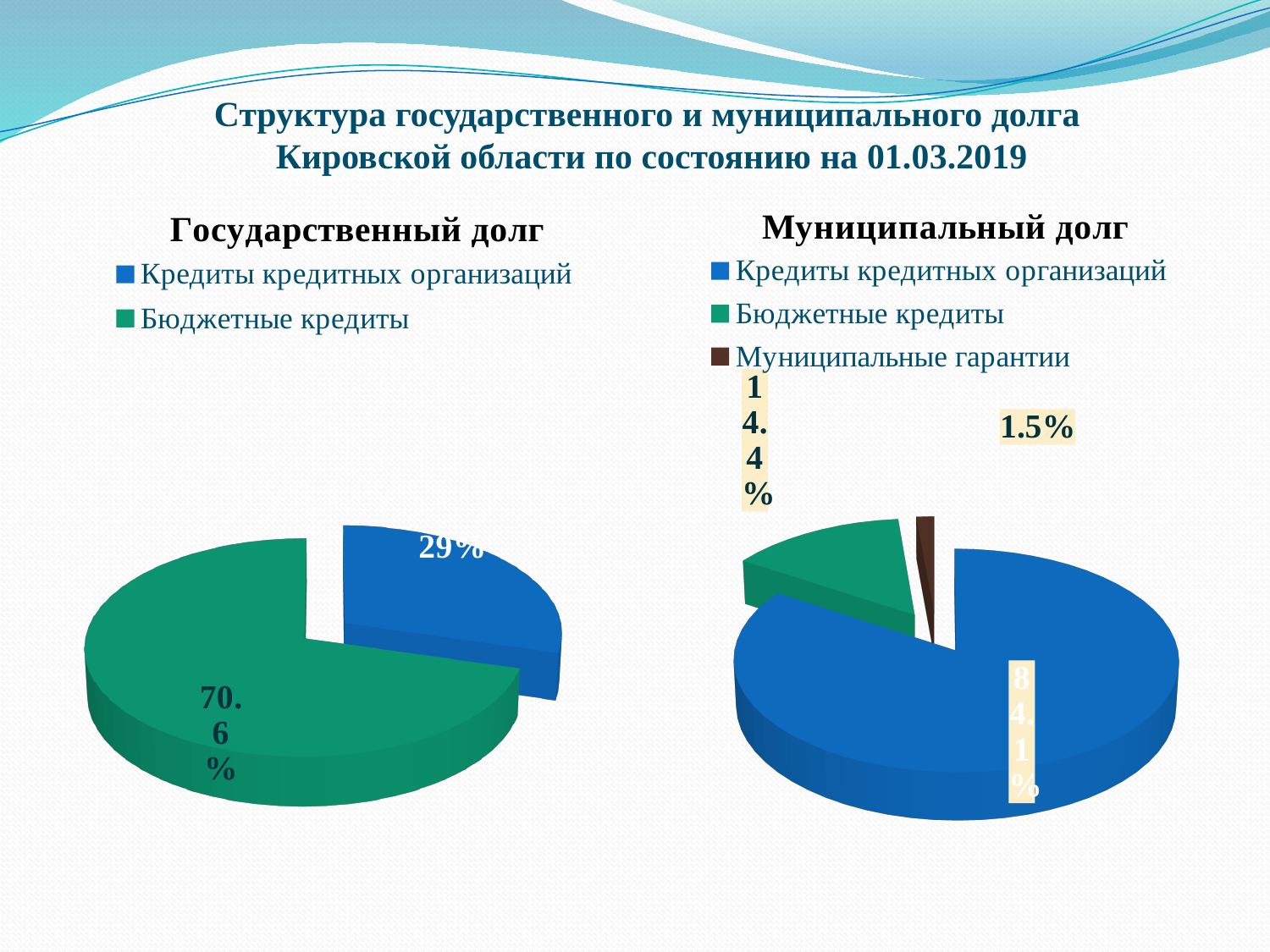
In the Муниципальный долг chart, what share is Бюджетные кредиты? 14.4% What kind of chart is used for the Государственный долг chart? pie chart How many categories does the Муниципальный долг chart show? 3 In the Государственный долг chart, is the share for Кредиты кредитных организаций greater or less than 50%? less In the Муниципальный долг chart, what share is Кредиты кредитных организаций? 84.1% In the Муниципальный долг chart, what share is Муниципальные гарантии? 1.5% How many entries does the legend of the Государственный долг chart list? 2 In the Муниципальный долг chart, what is the difference between the shares of Кредиты кредитных организаций and Бюджетные кредиты? 69.7% In the Государственный долг chart, what share is Бюджетные кредиты? 70.6% In the Муниципальный долг chart, which category has the smallest share? Муниципальные гарантии In the Государственный долг chart, which category has the largest share? Бюджетные кредиты In the Муниципальный долг chart, which colour represents Муниципальные гарантии? brown